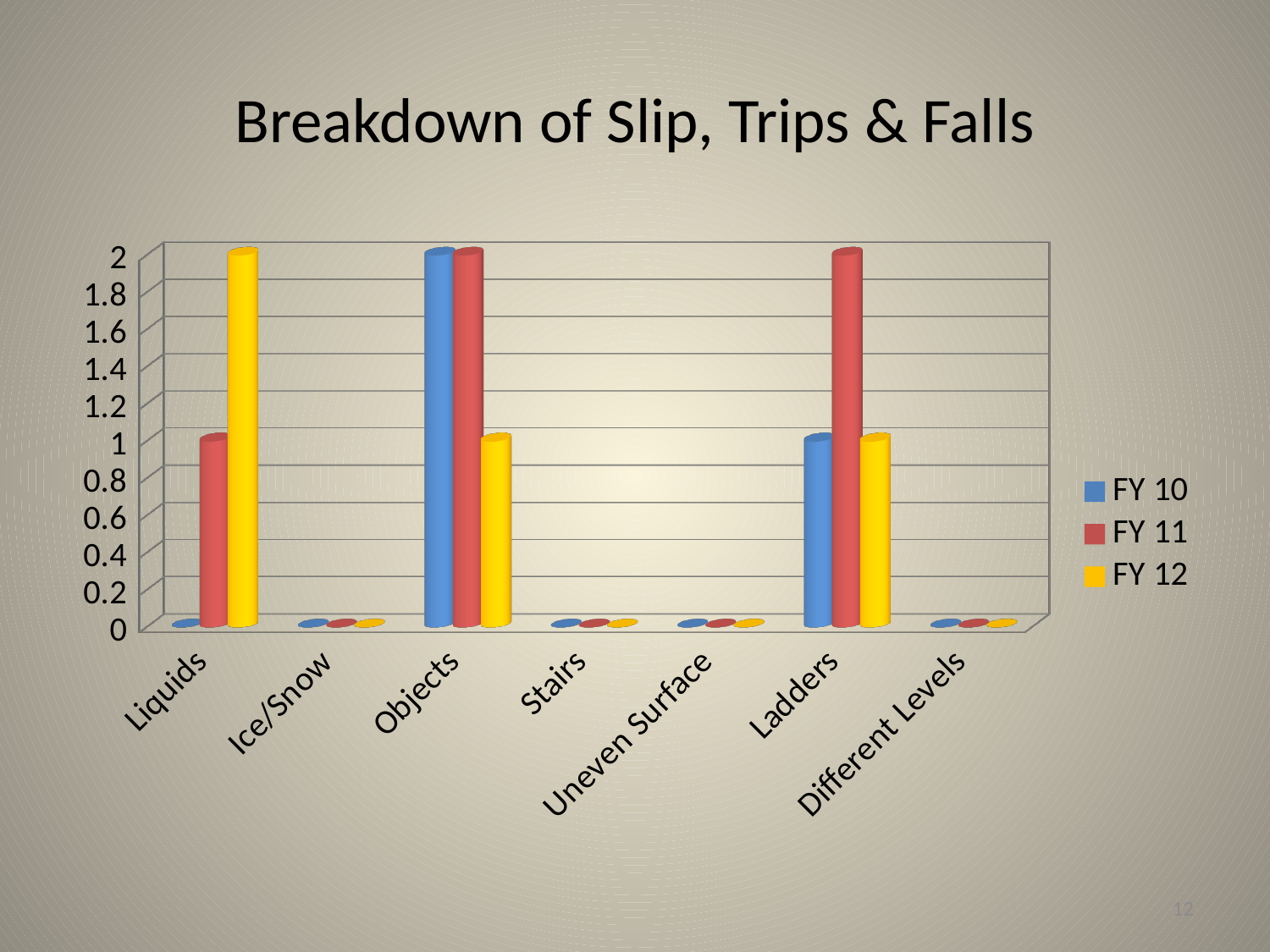
What is the FY 11 value for Liquids? 1 What kind of chart is shown on the slide? bar chart How many series does the legend list? 3 Which is larger for Ladders, the FY 10 value or the FY 11 value? FY 11 What is the FY 12 value for Objects? 1 What is the FY 12 value for Liquids? 2 Which category has the highest FY 10 value? Objects What is the title of the chart? Breakdown of Slip, Trips & Falls What is the difference between the FY 12 value for Liquids and the FY 11 value for Liquids? 1 How many categories are shown on the x axis? 7 Which series is shown in yellow in the legend? FY 12 What is the FY 11 value for Ladders? 2